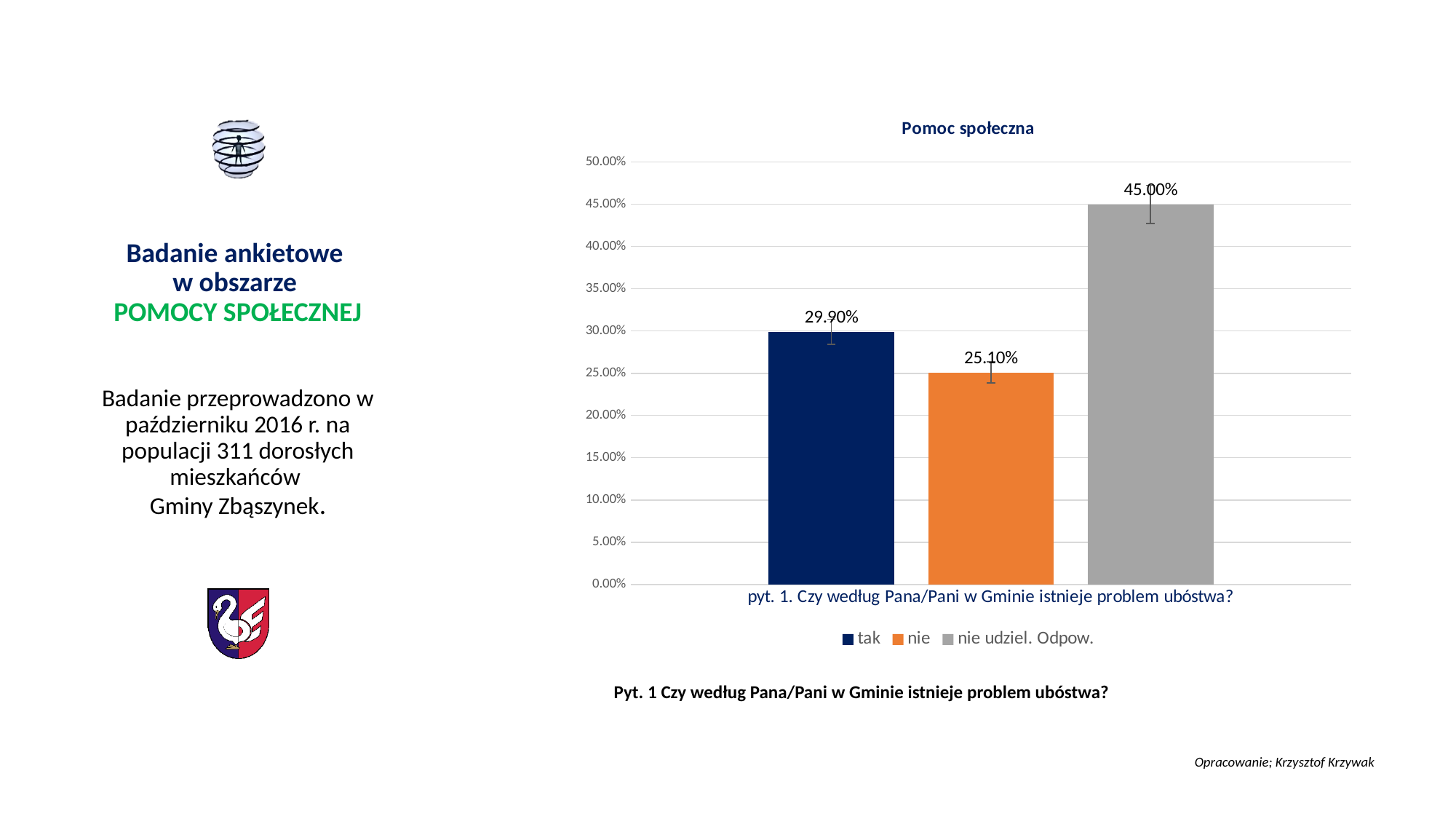
What is the difference between the values for "nie udziel. Odpow." and "tak"? 15.10% What is the value for "nie" in the chart? 25.10% How many series does the legend list? 3 What is the title of the chart? Pomoc społeczna What is the value for "nie udziel. Odpow." in the chart? 45.00% Is the value for "nie udziel. Odpow." greater or less than 40.00%? greater Which series has the highest value in the chart? nie udziel. Odpow. Which is larger, the value for "tak" or the value for "nie"? tak What is the value for "tak" in the chart? 29.90% What kind of chart is shown on the slide? bar chart Which series has the lowest value in the chart? nie What is the difference between the values for "tak" and "nie"? 4.80%